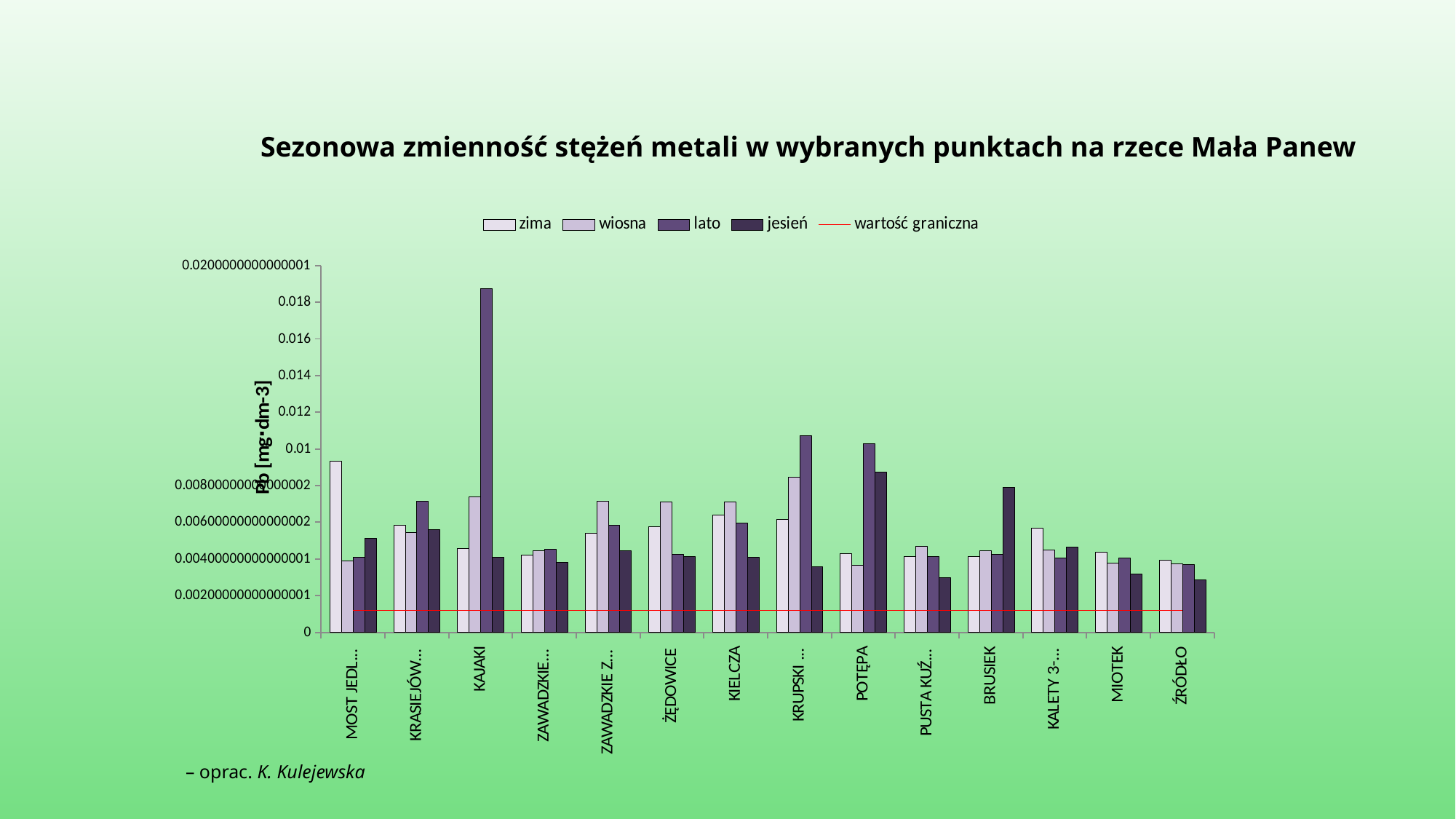
Which season has the highest bar at BRUSIEK? jesień What is the label of the y axis? Pb [mg·dm-3] How many entries does the chart legend list? 5 Is the 'lato' value for KAJAKI greater or less than 0.016? greater Is the 'jesień' value for ŹRÓDŁO greater or less than 0.004? less Which season has the highest bar at POTĘPA? lato At which sampling point is the 'lato' bar the highest? KAJAKI Which season has the lowest bar at ŹRÓDŁO? jesień How many sampling points (categories) are shown on the x axis? 14 Is the 'lato' value for POTĘPA greater or less than 0.008? greater Which is larger: the 'lato' value for KAJAKI or the 'lato' value for POTĘPA? KAJAKI What kind of chart is shown on the slide? bar chart